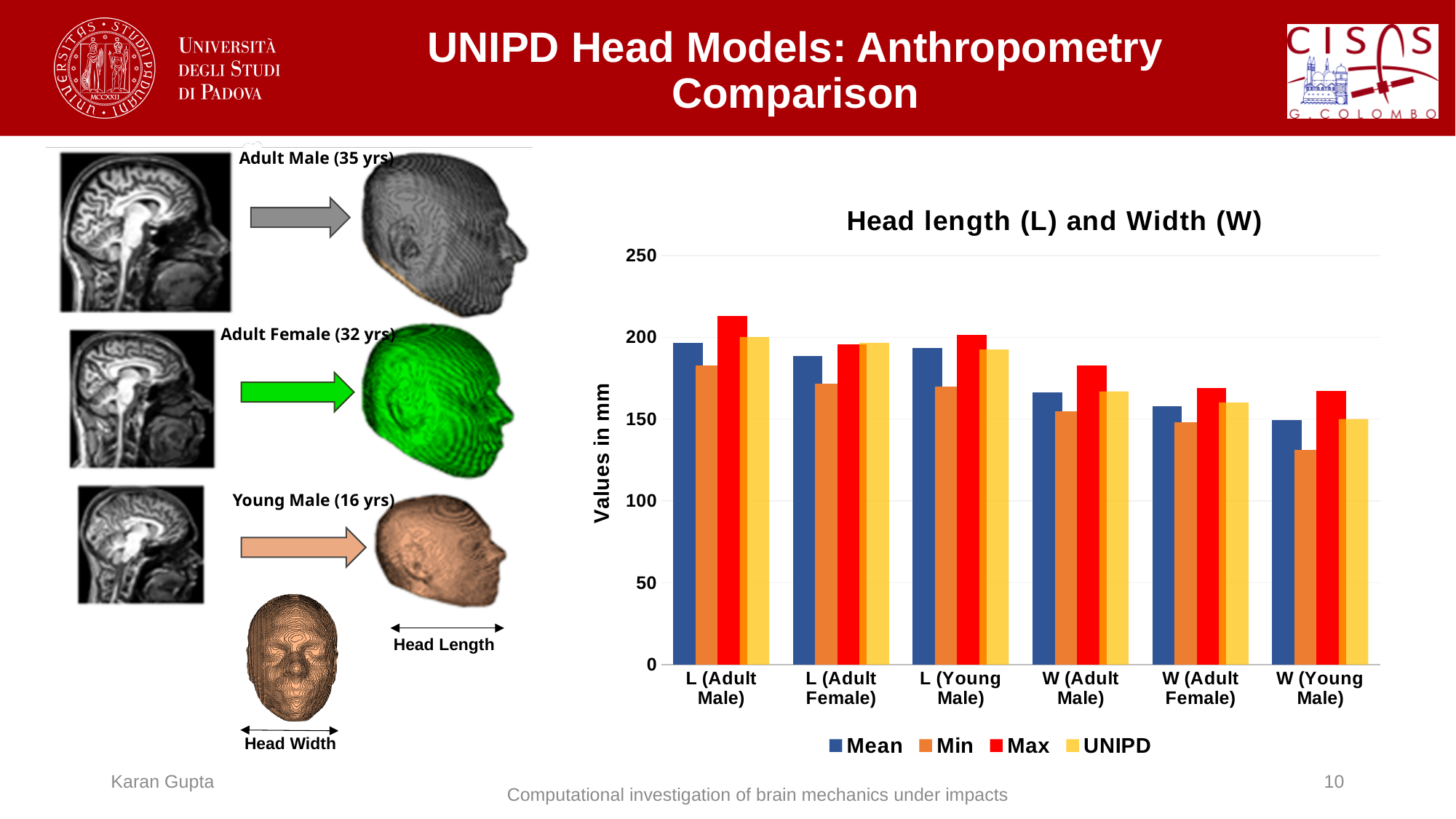
What kind of chart is shown on the slide? bar chart Is the Max value for W (Adult Female) greater or less than 150? greater Is the Max value for L (Adult Male) greater or less than 200? greater Is the Min value for W (Young Male) greater or less than 150? less Which category has the highest Max bar? L (Adult Male) What is the title of the chart? Head length (L) and Width (W) Which is larger: the Max value for L (Adult Male) or the Max value for W (Adult Male)? L (Adult Male) How many series does the legend of the chart list? 4 What is the label of the y axis of the chart? Values in mm How many categories are shown on the x axis of the chart? 6 Which category has the lowest Min bar? W (Young Male)